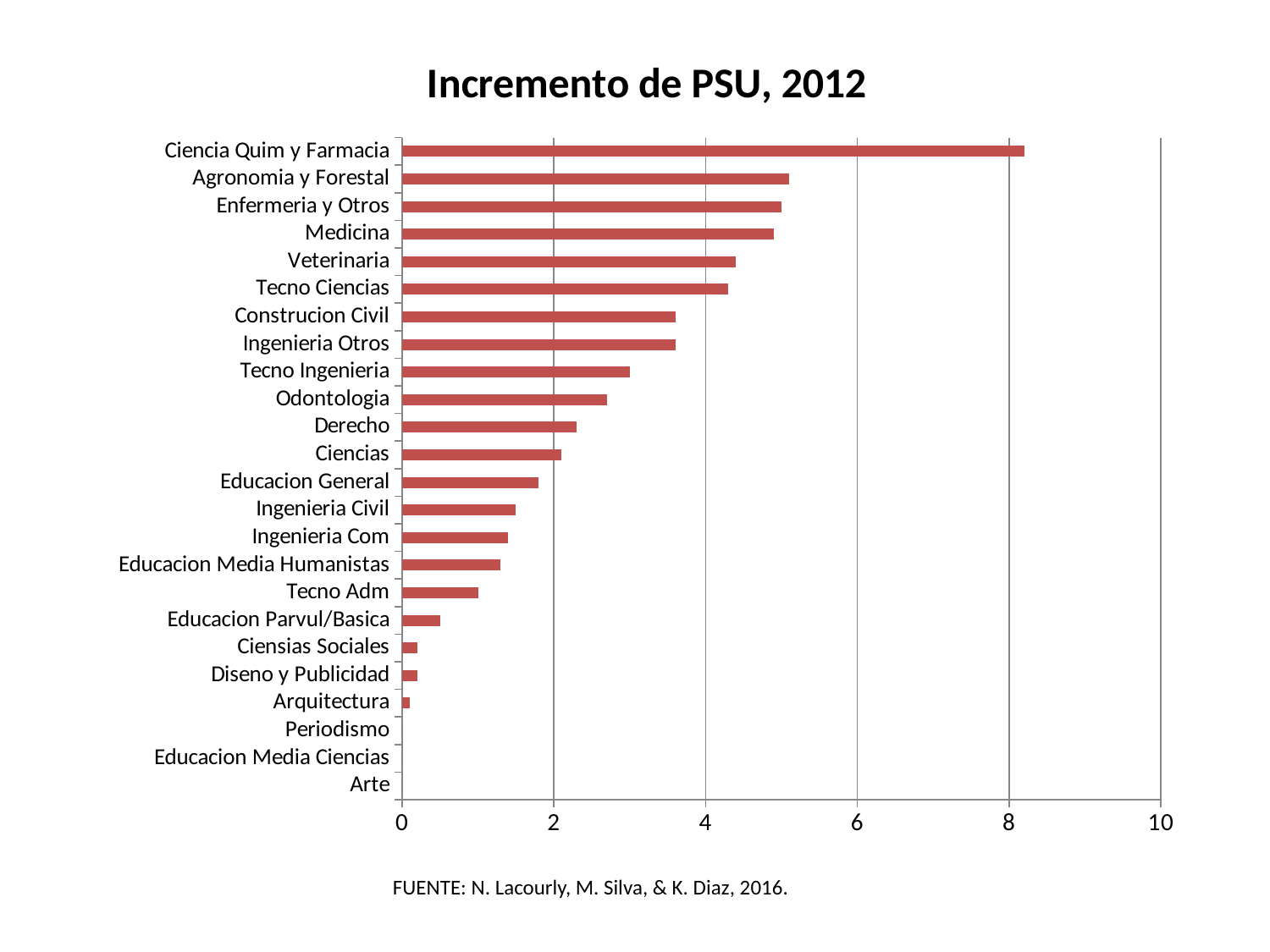
Is the value for Ciencia Quim y Farmacia greater or less than 6? greater Which category has the highest value in the chart? Ciencia Quim y Farmacia Do the bar values increase or decrease going from the top category to the bottom category? decrease What is the title of the chart? Incremento de PSU, 2012 Is the value for Tecno Ingenieria greater or less than 4? less Is the value for Medicina greater or less than 6? less How many categories are plotted in the chart? 24 What type of chart is shown on the slide? Bar chart Which is larger, the value for Derecho or the value for Tecno Adm? Derecho Which is larger, the value for Medicina or the value for Tecno Ingenieria? Medicina